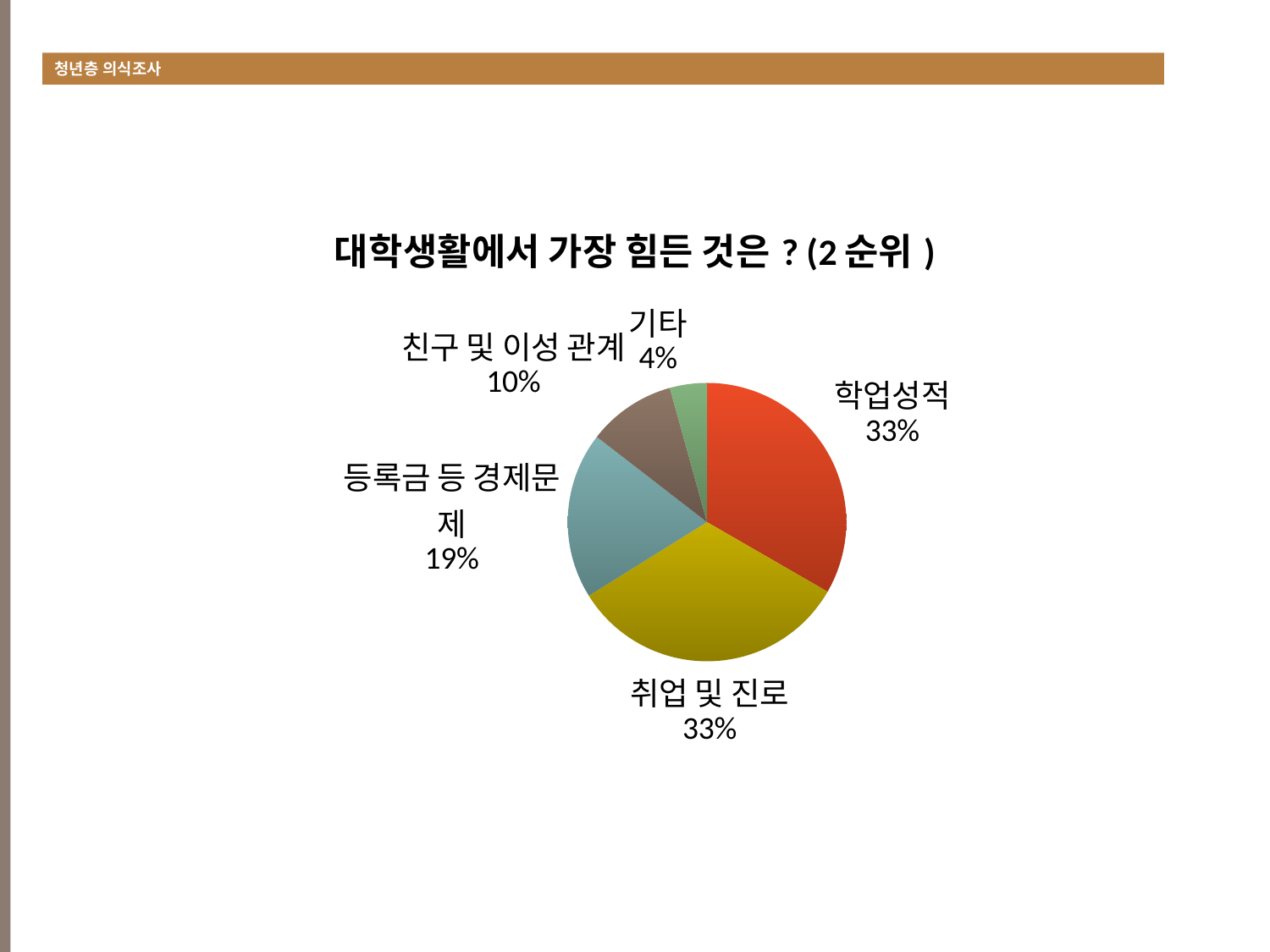
What share of the pie does 등록금 등 경제문제 have? 19% Which category has the smallest slice of the pie? 기타 What share of the pie does 기타 have? 4% What is the difference between the shares of 등록금 등 경제문제 and 친구 및 이성 관계? 9% Which is larger, the share for 등록금 등 경제문제 or the share for 기타? 등록금 등 경제문제 What kind of chart is shown on the slide? pie chart What share of the pie does 친구 및 이성 관계 have? 10% How many slices does the pie chart have? 5 What is the difference between the shares of 학업성적 and 기타? 29% What is the title of the chart? 대학생활에서 가장 힘든 것은 ? (2 순위 )